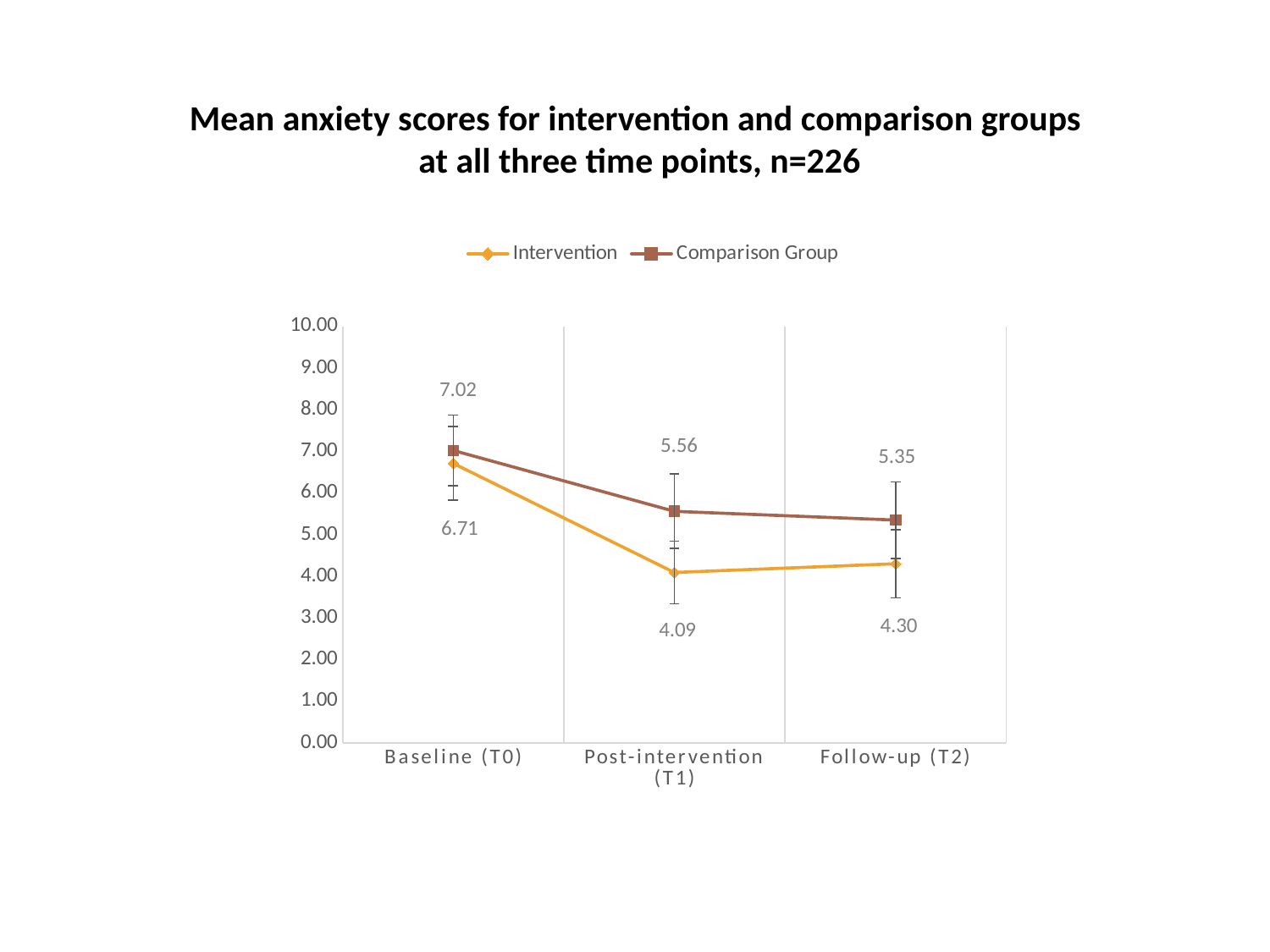
What kind of chart is shown on the slide? Line chart Does the Comparison Group's mean anxiety score rise or fall from Baseline (T0) to Follow-up (T2)? Fall What is the mean anxiety score for the Intervention group at Follow-up (T2)? 4.30 What is the mean anxiety score for the Comparison Group at Follow-up (T2)? 5.35 What is the difference between the Comparison Group and Intervention scores at Post-intervention (T1)? 1.47 How many time points are shown on the x axis? 3 At which time point is the Comparison Group's mean anxiety score highest? Baseline (T0) At which time point is the Intervention group's mean anxiety score lowest? Post-intervention (T1) What is the mean anxiety score for the Comparison Group at Post-intervention (T1)? 5.56 What is the mean anxiety score for the Intervention group at Baseline (T0)? 6.71 How many series does the legend list? 2 Which group has the higher mean anxiety score at Follow-up (T2)? Comparison Group